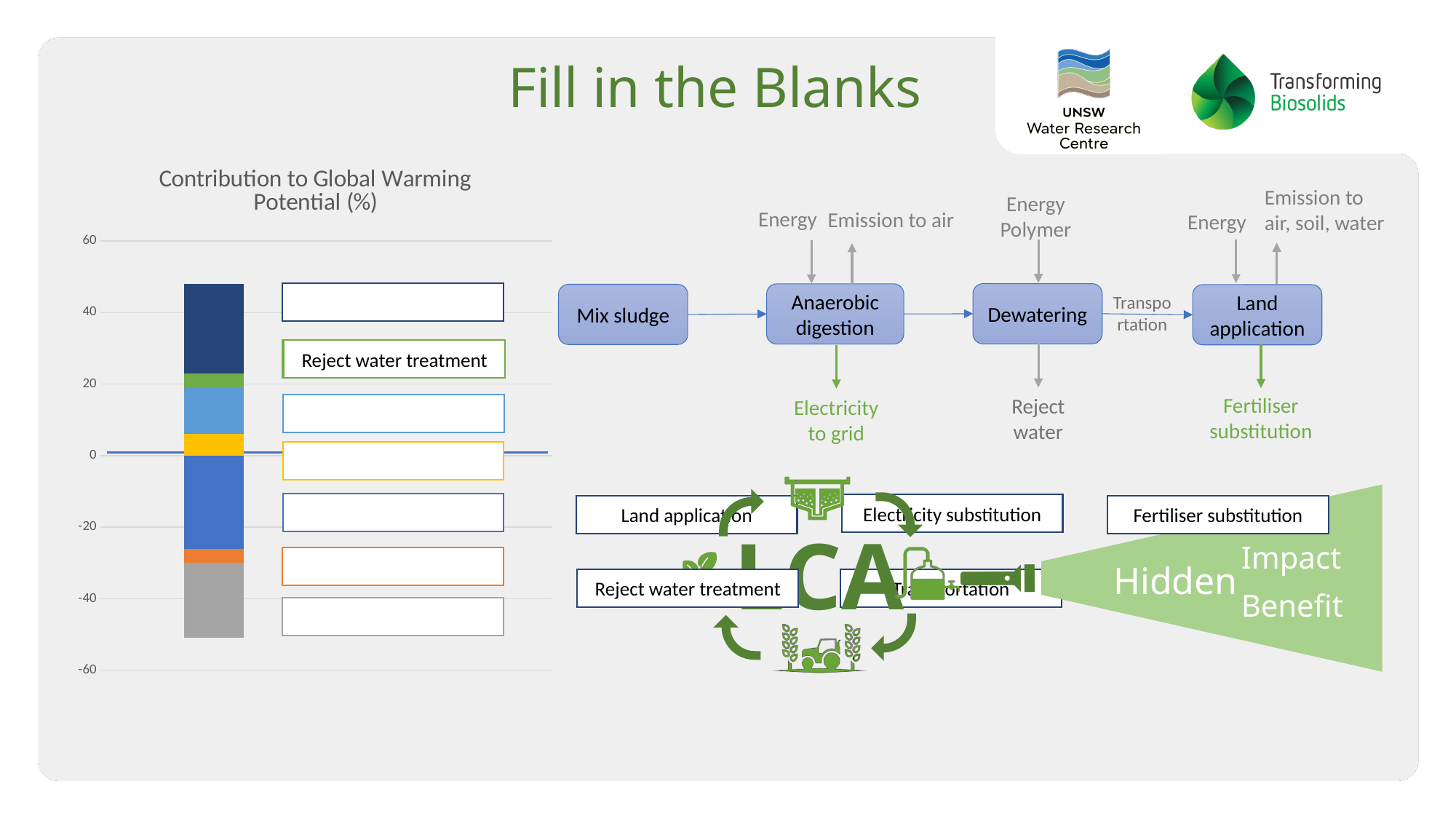
What kind of chart is shown on the left of the slide? Stacked bar chart What is the highest value shown on the chart's vertical axis? 60 Which legend entry in the chart is filled in with a label? Reject water treatment How many coloured segments make up the stacked bar in the chart? 7 Does the bottom of the stacked bar extend below -40 on the axis? Yes How many legend boxes are shown beside the stacked bar? 7 What is the lowest value shown on the chart's vertical axis? -60 Does the top of the stacked bar reach above or below 40 on the axis? above Is the Reject water treatment segment of the stacked bar above or below 0 on the axis? above